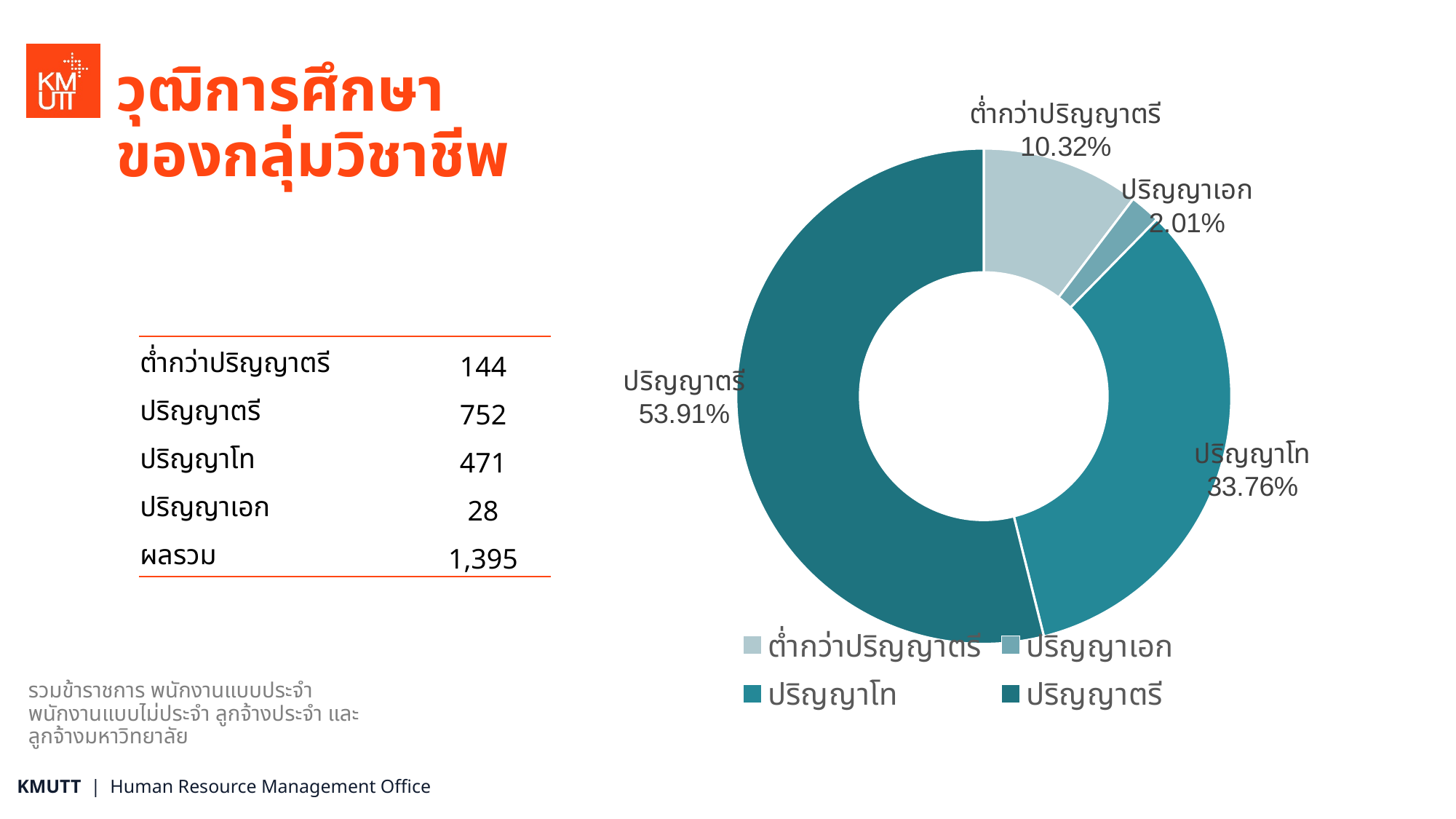
How many categories are shown in the chart? 4 What percentage share does ปริญญาตรี have in the chart? 53.91% Which has a larger share in the chart, ปริญญาโท or ต่ำกว่าปริญญาตรี? ปริญญาโท What type of chart is shown on the slide? Doughnut chart How many entries does the chart legend list? 4 What percentage share does ต่ำกว่าปริญญาตรี have in the chart? 10.32% What is the difference in percentage points between the shares of ปริญญาตรี and ปริญญาโท? 20.15 According to the table on the slide, what is the total (ผลรวม) count? 1,395 What percentage share does ปริญญาโท have in the chart? 33.76% Which category has the smallest share in the chart? ปริญญาเอก Which category has the largest share in the chart? ปริญญาตรี